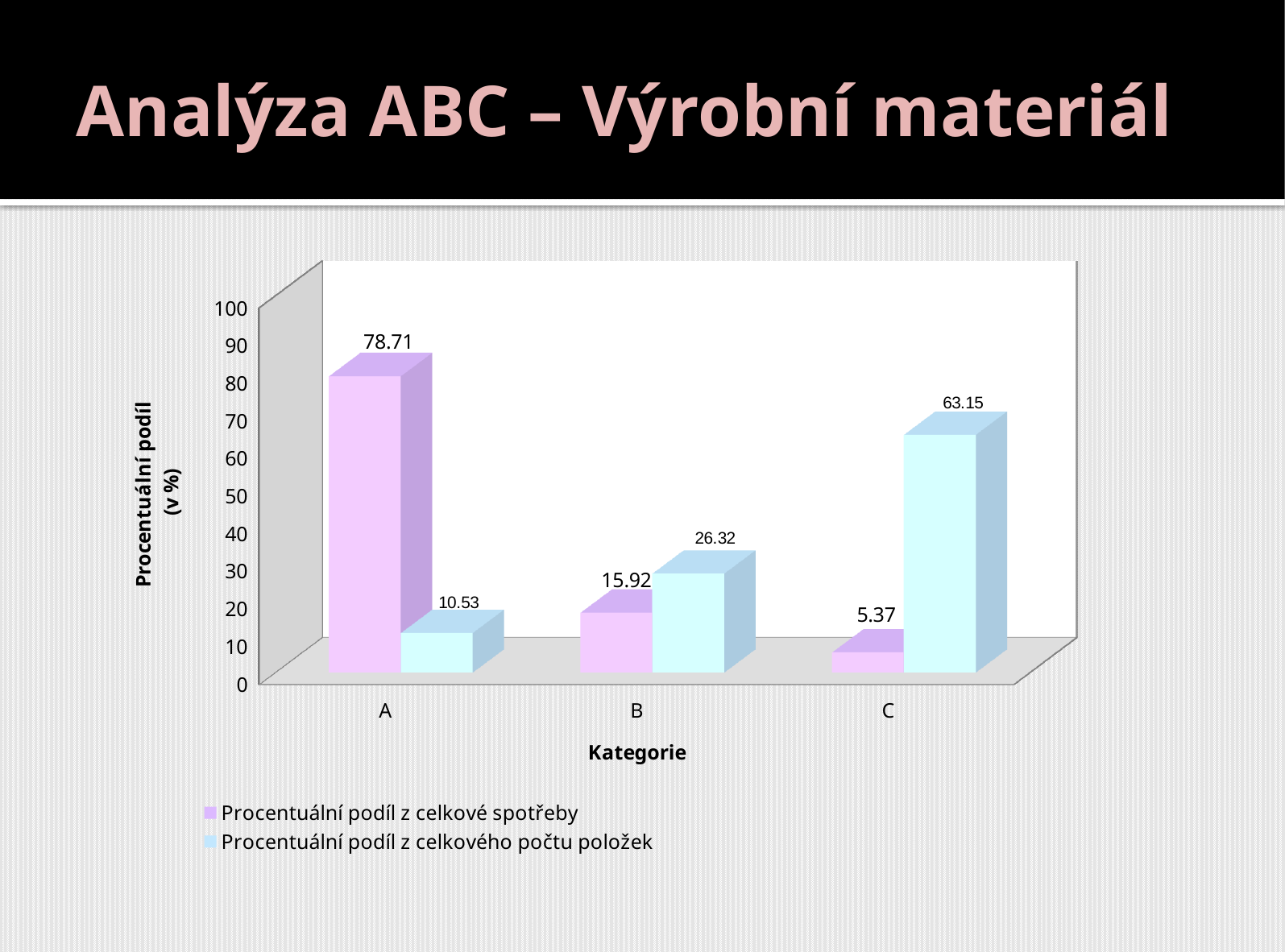
What is the value of 'Procentuální podíl z celkového počtu položek' for category C? 63.15 What is the difference between the two series' values for category B? 10.40 How many categories are shown on the x axis? 3 Which category has the highest value for 'Procentuální podíl z celkové spotřeby'? A What is the value of 'Procentuální podíl z celkové spotřeby' for category A? 78.71 Do the values of 'Procentuální podíl z celkové spotřeby' rise or fall from category A to category C? Fall Which category has the lowest value for 'Procentuální podíl z celkového počtu položek'? A What kind of chart is shown on the slide? Bar chart For category C, which series has the larger value: 'Procentuální podíl z celkové spotřeby' or 'Procentuální podíl z celkového počtu položek'? Procentuální podíl z celkového počtu položek How many series does the legend list? 2 What is the value of 'Procentuální podíl z celkového počtu položek' for category A? 10.53 What is the value of 'Procentuální podíl z celkové spotřeby' for category B? 15.92